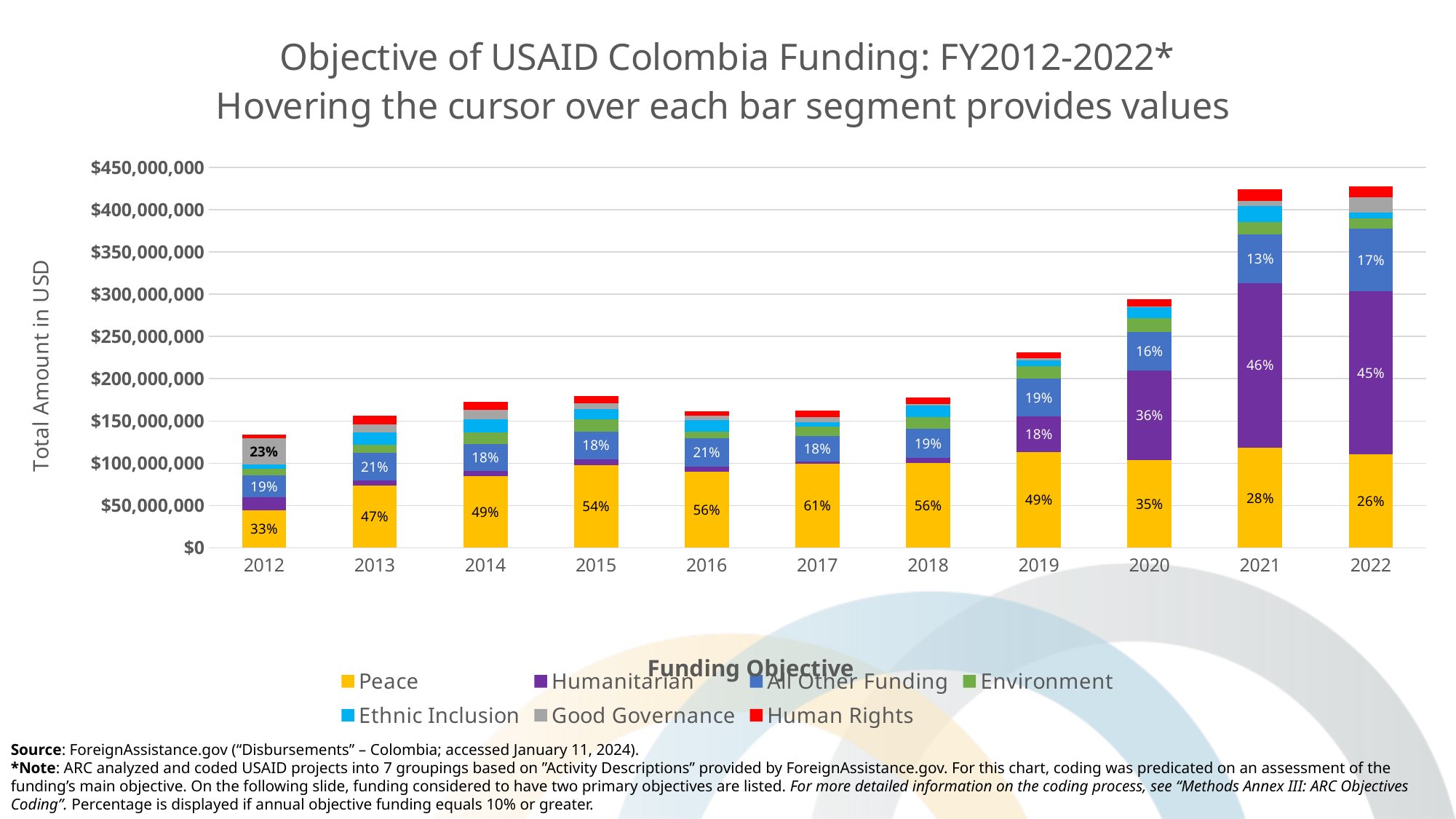
What percentage of funding went to Good Governance in 2012? 23% What type of chart is shown on the slide? Stacked bar chart In 2021, which is larger: the Humanitarian share or the Peace share? Humanitarian How many funding objectives does the legend list? 7 How many fiscal years are shown on the x axis? 11 Which year has the lowest total funding amount? 2012 What percentage of funding went to Humanitarian in 2021? 46% What percentage of funding went to Peace in 2017? 61% Is the total funding for 2022 greater or less than $400,000,000? greater What percentage of funding went to All Other Funding in 2020? 16% By how many percentage points does the Peace share in 2017 exceed the Peace share in 2022? 35 percentage points Which year has the highest Peace percentage label? 2017